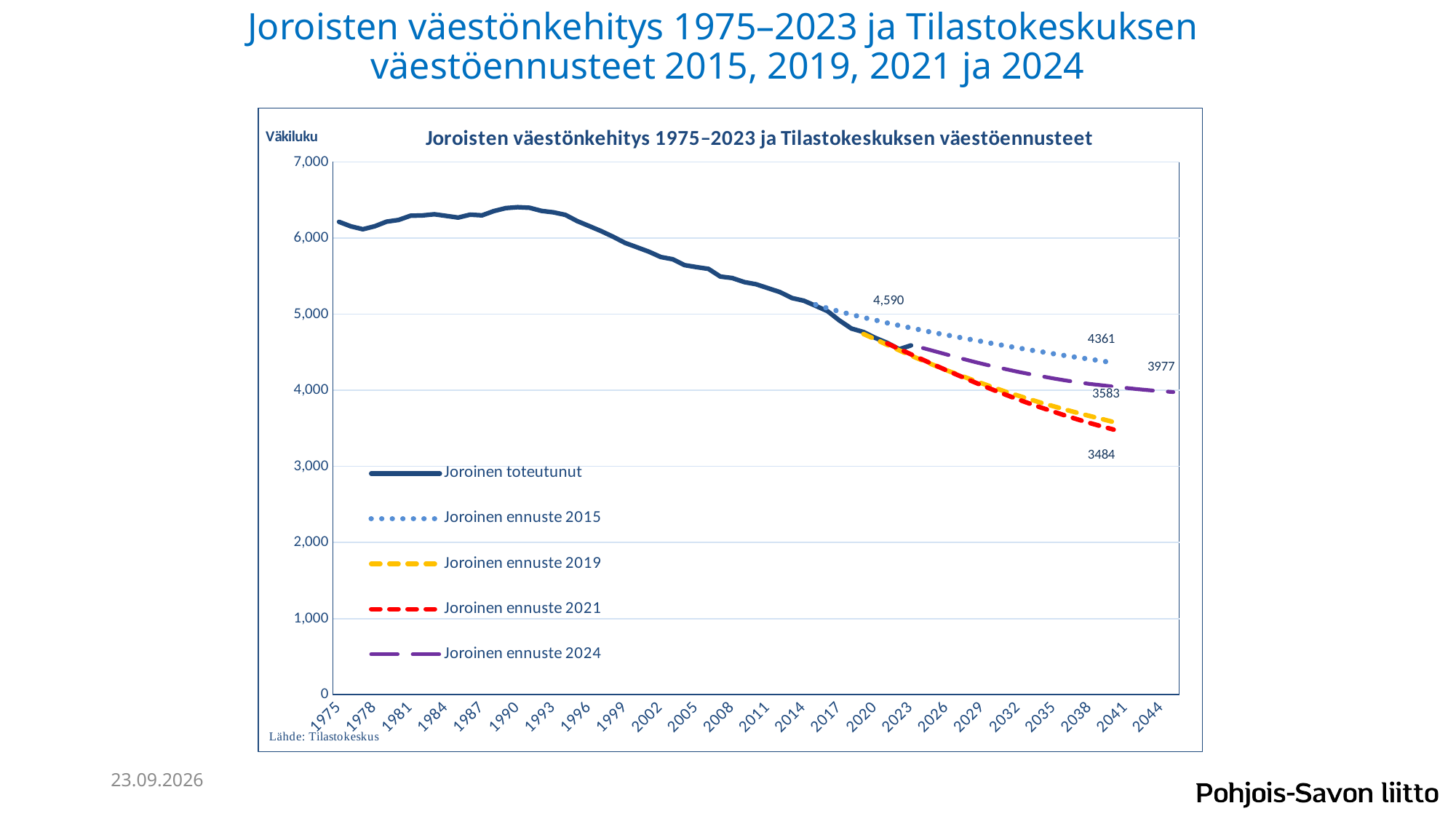
Does the Joroinen toteutunut line rise or fall from 1993 to 2023? fall What is the final labelled value of the Joroinen ennuste 2019 series? 3583 What is the difference between the final labelled values of Joroinen ennuste 2024 (3977) and Joroinen ennuste 2019 (3583)? 394 What is the final labelled value of the Joroinen ennuste 2015 series? 4361 What kind of chart is shown on the slide? line chart Which forecast series ends at the lowest labelled value? Joroinen ennuste 2021 Is the Joroinen toteutunut value in 1990 greater or less than 6,000? greater What is the difference between the final labelled values of Joroinen ennuste 2015 (4361) and Joroinen ennuste 2021 (3484)? 877 What is the final labelled value of the Joroinen ennuste 2024 series? 3977 How many series does the legend list? 5 What is the final labelled value of the Joroinen ennuste 2021 series? 3484 Which forecast ends at a higher value, Joroinen ennuste 2015 or Joroinen ennuste 2024? Joroinen ennuste 2015